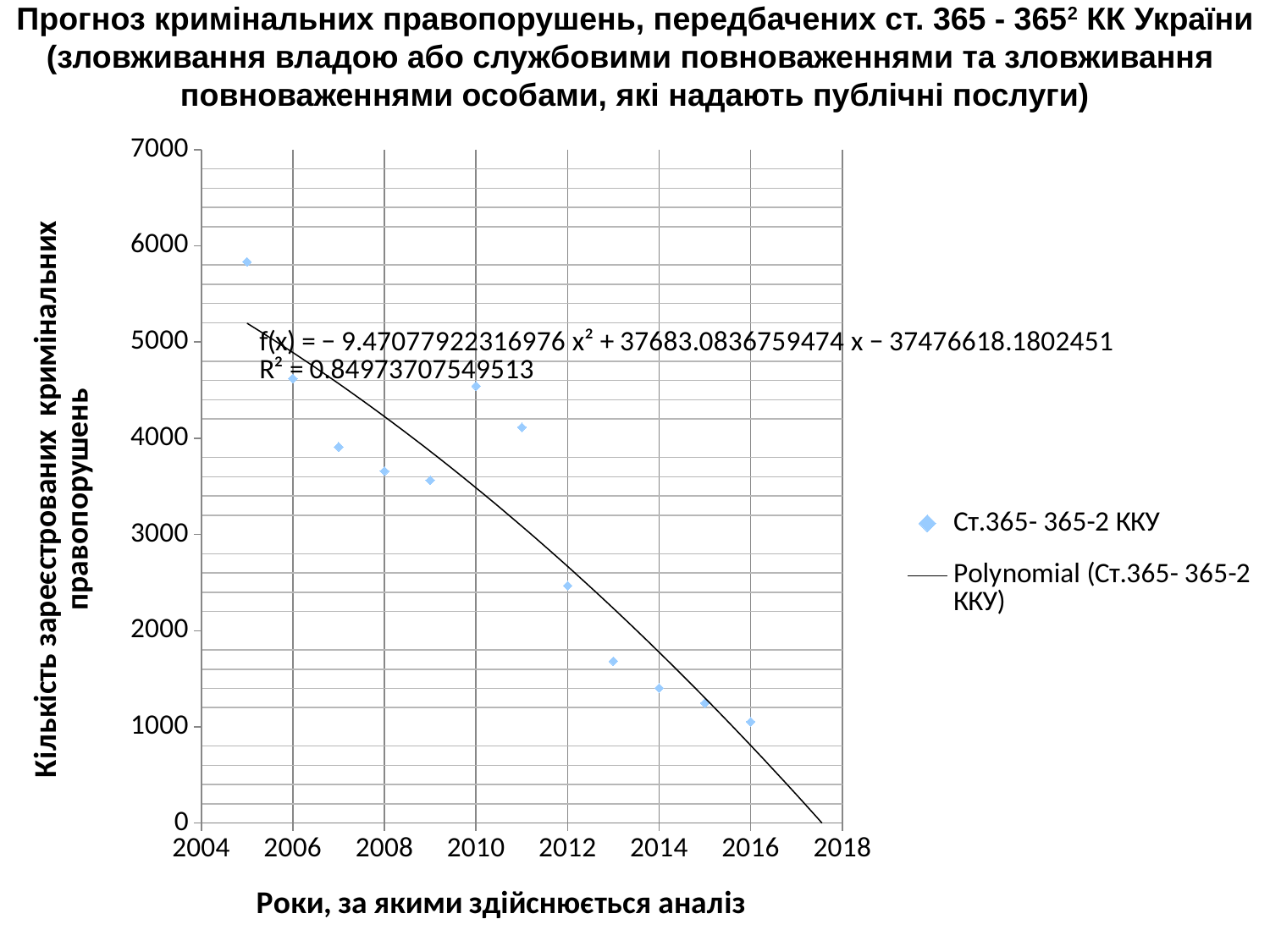
Which year has the larger value, 2010 or 2011? 2010 What R² value is shown for the polynomial trendline? 0.84973707549513 Is the value for 2010 greater or less than 4000? greater Is the value for 2013 greater or less than 2000? less Is the value for 2012 greater or less than 3000? less In which year is the number of registered offences lowest? 2016 How many entries does the legend list? 2 How many data points are plotted for the series Ст.365- 365-2 ККУ? 12 In which year is the number of registered offences highest? 2005 Do the plotted values generally rise or fall from 2005 to 2016? fall What kind of chart is shown on the slide? scatter chart